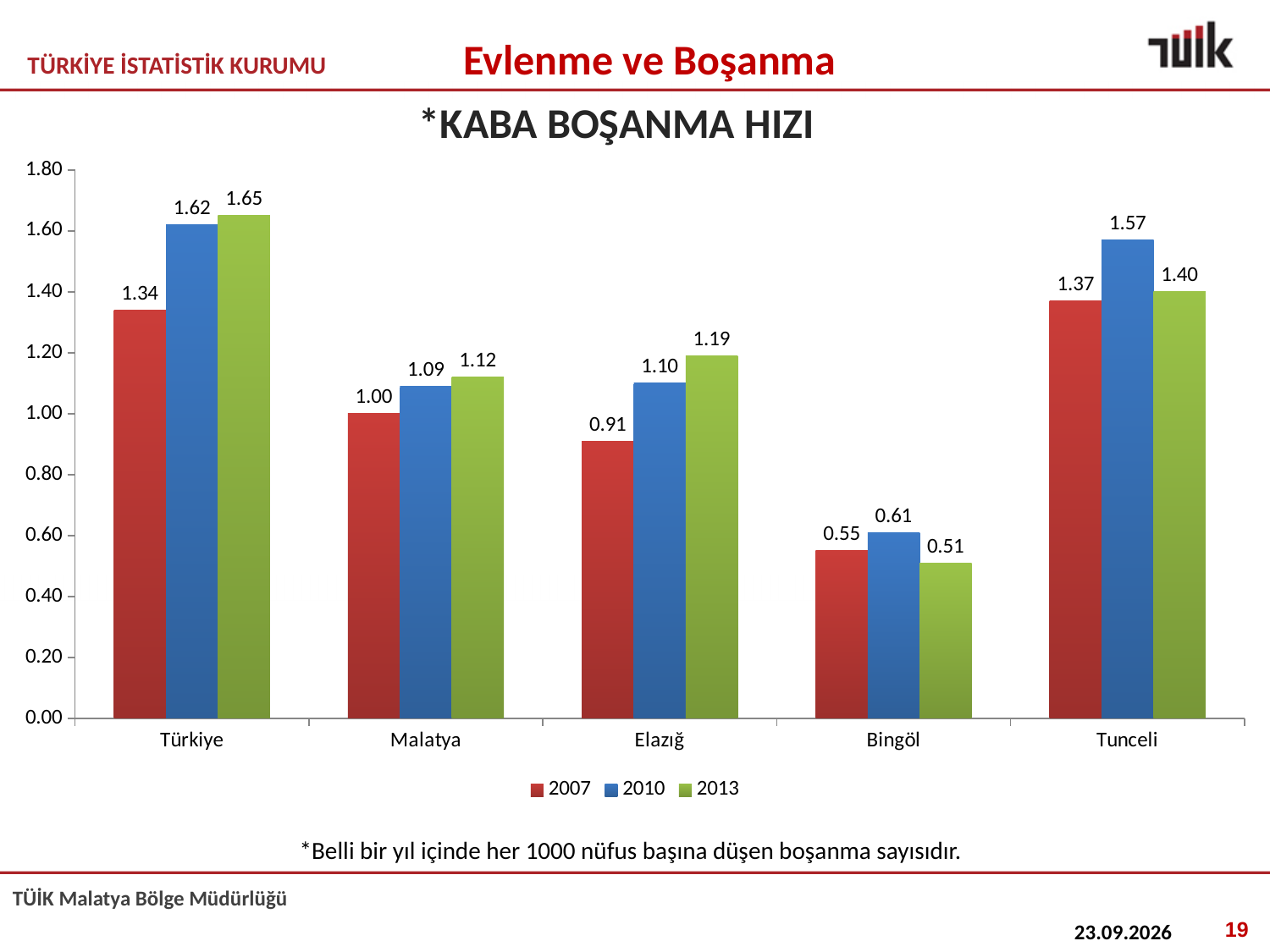
How many series does the legend list? 3 Which category has the lowest value for 2007? Bingöl What is the title of the chart? *KABA BOŞANMA HIZI How many categories are shown on the x axis? 5 Is the 2010 value for Tunceli greater or less than 1.40? greater What is the difference between the 2013 and 2007 values for Elazığ? 0.28 What is the value for Tunceli in 2013? 1.40 Which category has the highest value for 2013? Türkiye What is the crude divorce rate for Malatya in 2010? 1.09 Which is larger for Bingöl: the 2010 value or the 2013 value? 2010 What kind of chart is shown on the slide? bar chart Do the values for Malatya rise or fall from 2007 to 2013? rise